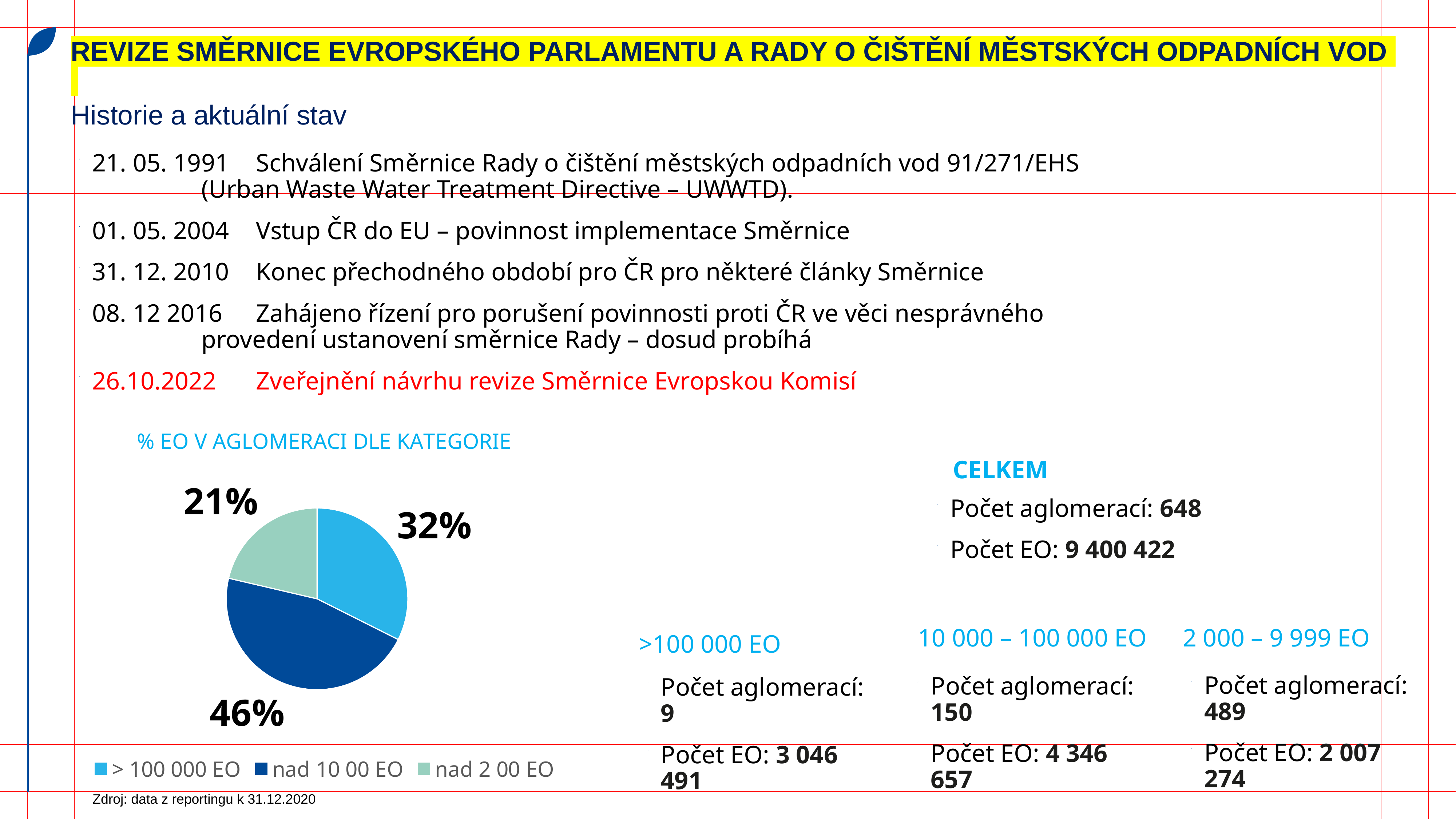
How many entries does the pie chart legend list? 3 What kind of chart is shown on the slide? pie chart Which colour is used for the "nad 2 00 EO" slice in the pie chart? light green What is the title of the pie chart? % EO V AGLOMERACI DLE KATEGORIE Which category has the smallest slice in the pie chart? nad 2 00 EO What share of the pie does the "nad 10 00 EO" slice represent? 46% What is the difference in percentage points between the "nad 10 00 EO" slice and the "> 100 000 EO" slice? 14 What share of the pie does the "> 100 000 EO" slice represent? 32% How many slices does the pie chart have? 3 What share of the pie does the "nad 2 00 EO" slice represent? 21% Which category has the largest slice in the pie chart? nad 10 00 EO Which slice is larger, "> 100 000 EO" or "nad 2 00 EO"? > 100 000 EO